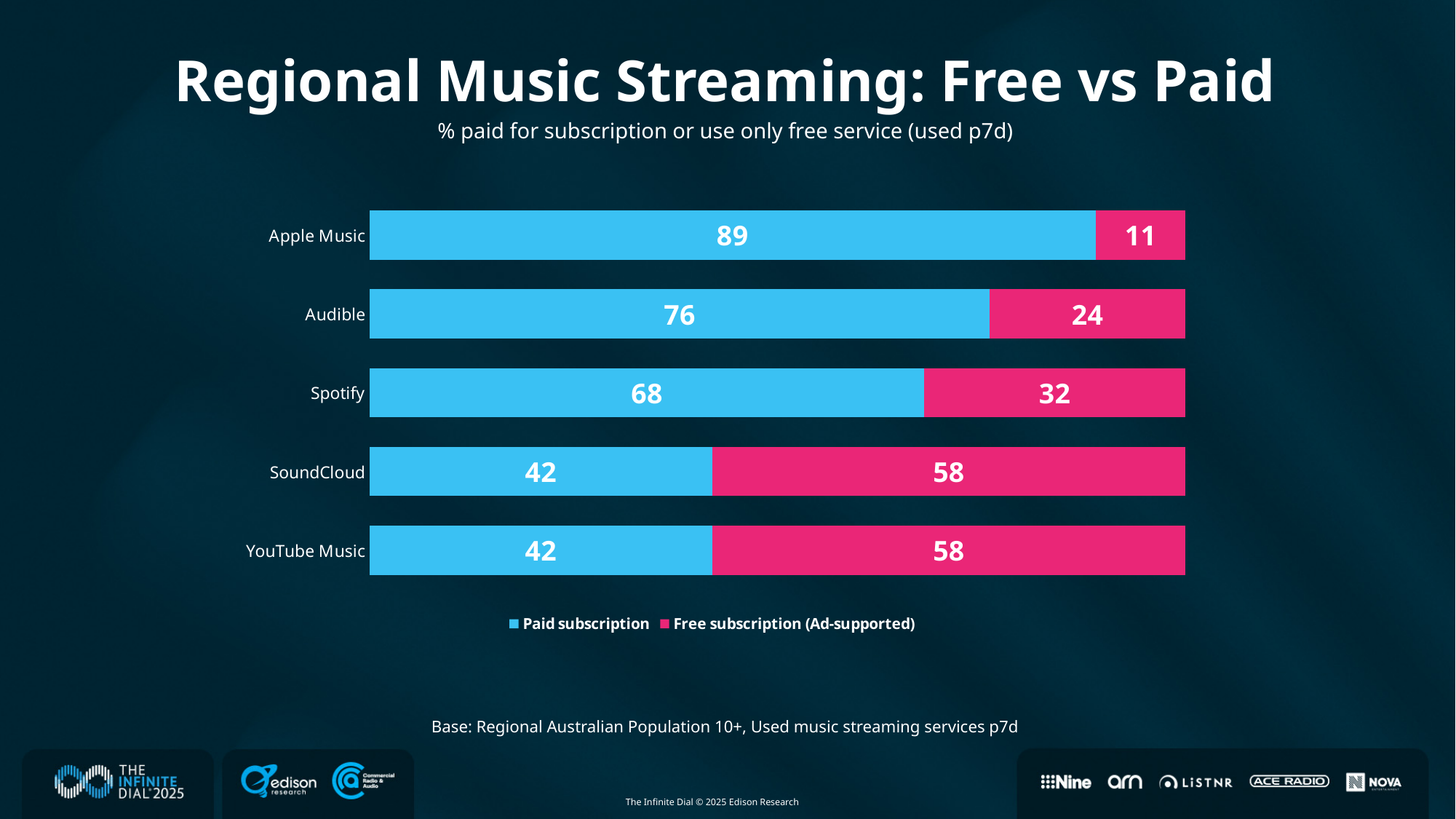
Which service has the lowest Free subscription (Ad-supported) value? Apple Music What is the Paid subscription value for Apple Music? 89 Which is larger: the Paid subscription value for Spotify or for SoundCloud? Spotify How many services are shown in the chart? 5 What is the total of the stacked bar for YouTube Music? 100 Which service has the highest Paid subscription value? Apple Music How many series does the legend list? 2 What is the Free subscription (Ad-supported) value for Audible? 24 What kind of chart is shown on the slide? Stacked bar chart What is the difference between the Paid subscription values for Audible and Spotify? 8 What is the Free subscription (Ad-supported) value for Spotify? 32 Which colour represents Free subscription (Ad-supported) in the chart? Pink